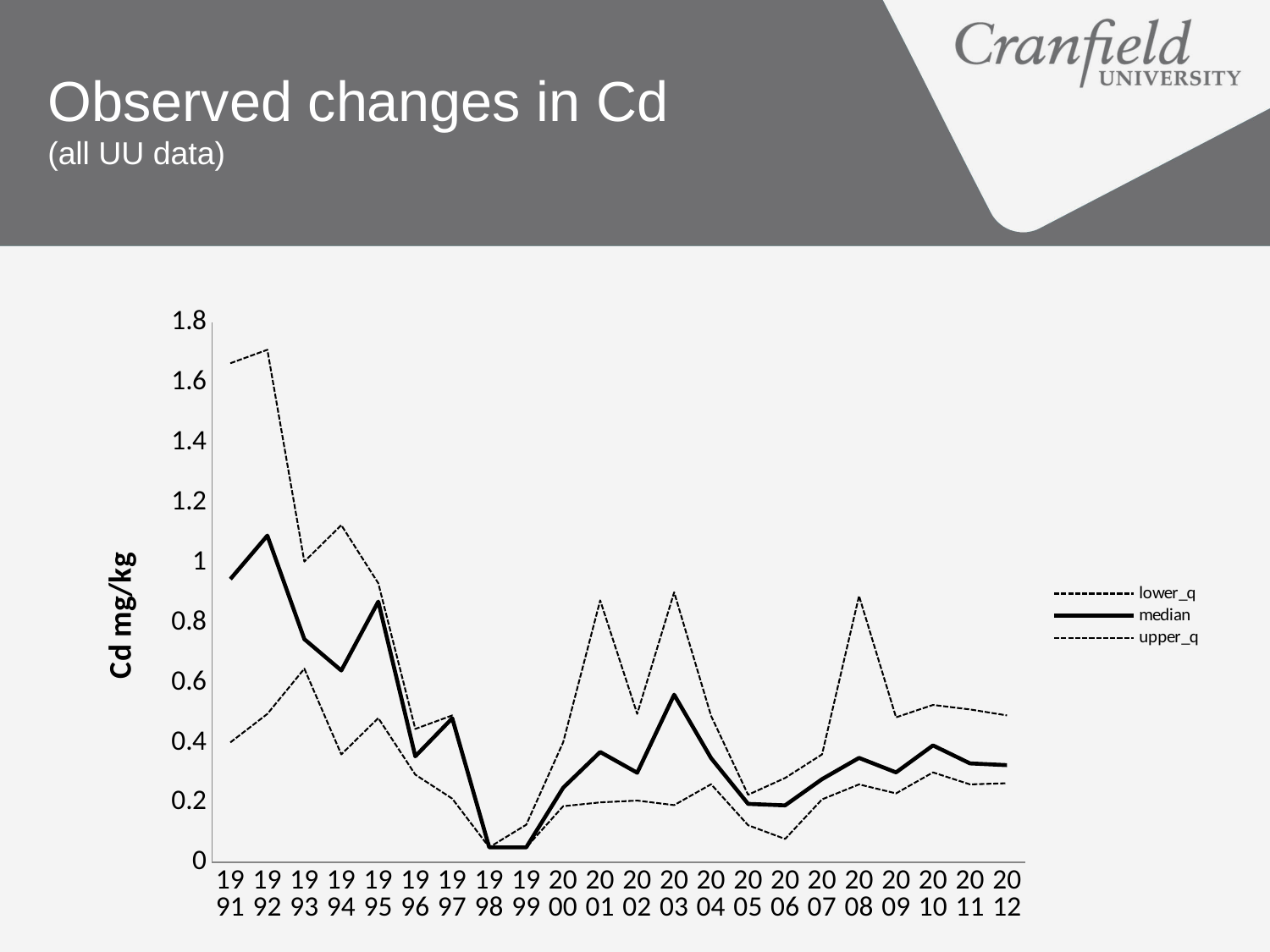
What is the title of the y axis? Cd mg/kg How many series does the legend list? 3 How many years are plotted along the x axis? 22 Is the median value for 2012 greater or less than 0.4? less Which series is drawn with a solid line rather than a dashed line? median Is the upper_q value for 1992 greater or less than 1.6? greater Which is larger, the median value for 1991 or the median value for 2012? 1991 Is the median value for 1992 greater or less than 1? greater Overall, does the median series rise or fall from 1991 to 2012? fall What kind of chart is shown on the slide? line chart In which year does the lower_q series reach its highest value? 1993 In which year does the median series reach its highest value? 1992